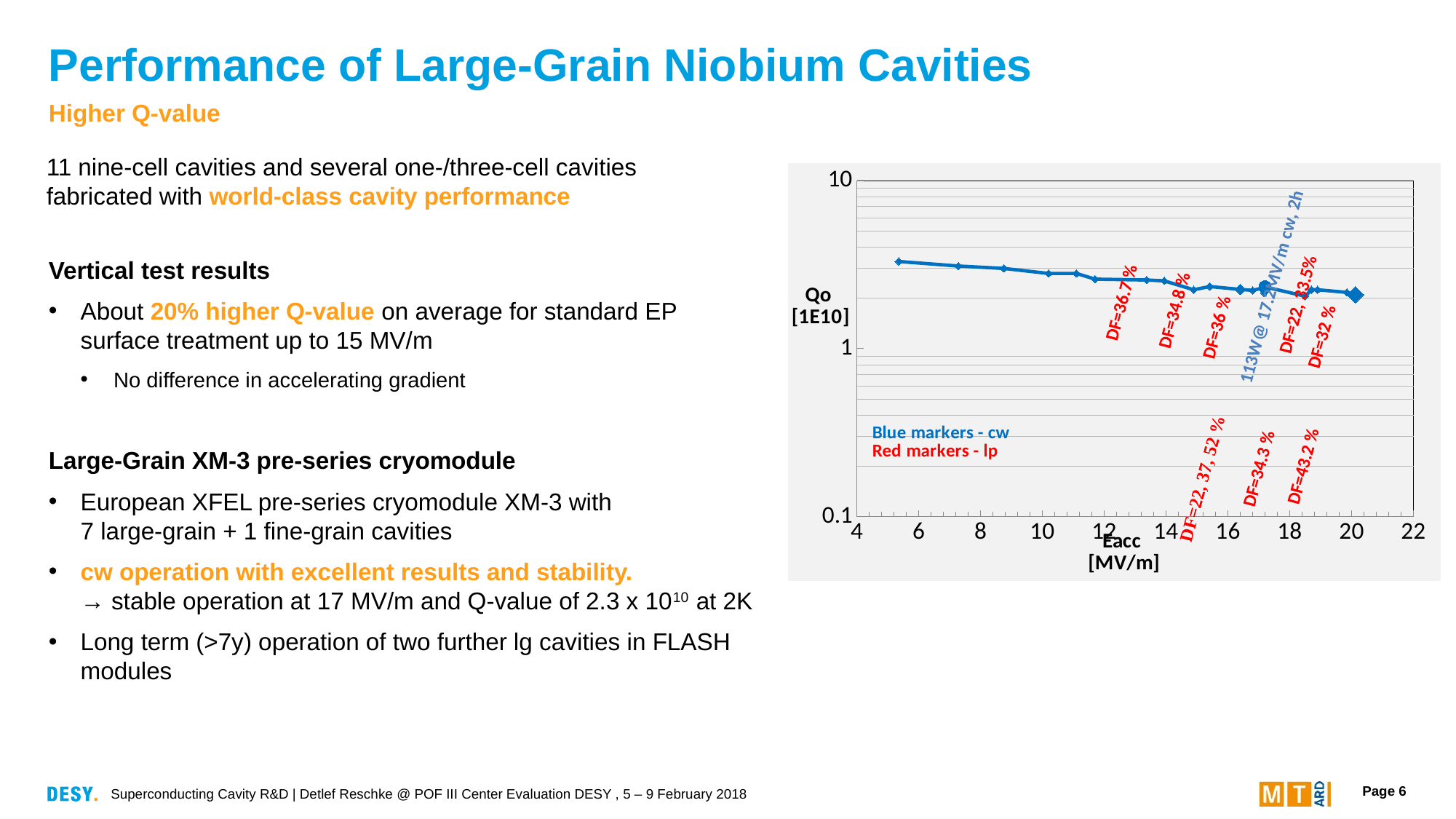
Is the Qo value of the blue curve at the highest Eacc point greater or less than 10? less What is the highest value shown on the x axis of the chart? 22 Does the Qo value rise or fall as Eacc increases along the x axis? fall What is the label of the y axis of the chart? Qo [1E10] Is the Qo value at the lowest Eacc point greater or less than the Qo value at the highest Eacc point? greater What is the lowest value shown on the y axis of the chart? 0.1 Is the Qo value of the blue curve at about 20 MV/m greater or less than 1? greater Is the Qo value of the blue curve at the lowest Eacc point greater or less than 1? greater What kind of chart is shown on the slide? line chart